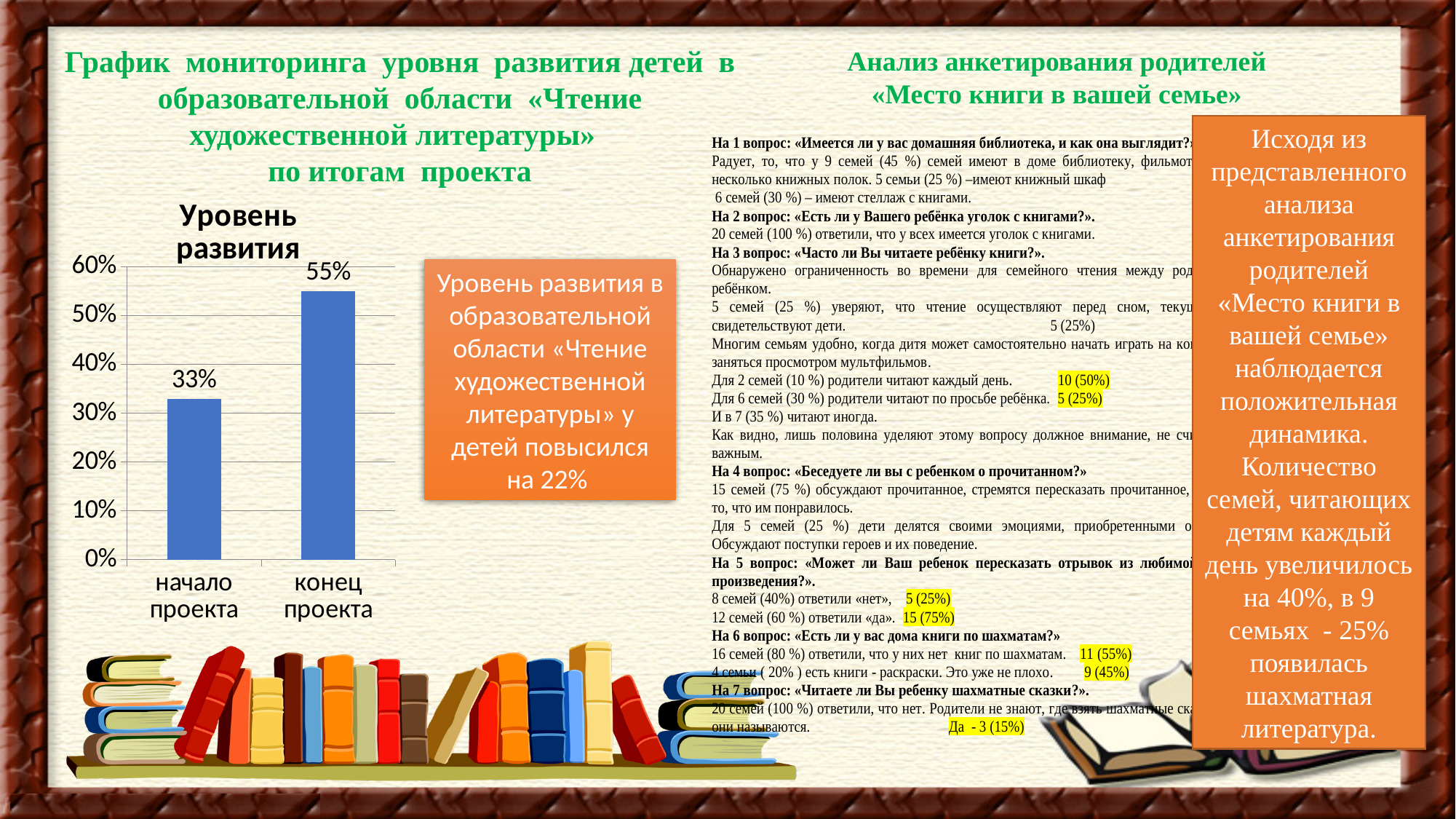
What is the difference between the values for "конец проекта" and "начало проекта"? 22% What is the value for "начало проекта" in the chart? 33% How many categories are shown in the chart? 2 What is the title of the chart? Уровень развития Which category has the highest value in the chart? конец проекта Is the value for "начало проекта" greater or less than 40%? less Is the value for "конец проекта" greater or less than 50%? greater Do the values rise or fall from "начало проекта" to "конец проекта"? rise Which category has the lowest value in the chart? начало проекта What is the value for "конец проекта" in the chart? 55% What kind of chart is shown on the slide? bar chart Which is larger: the value for "начало проекта" or for "конец проекта"? конец проекта